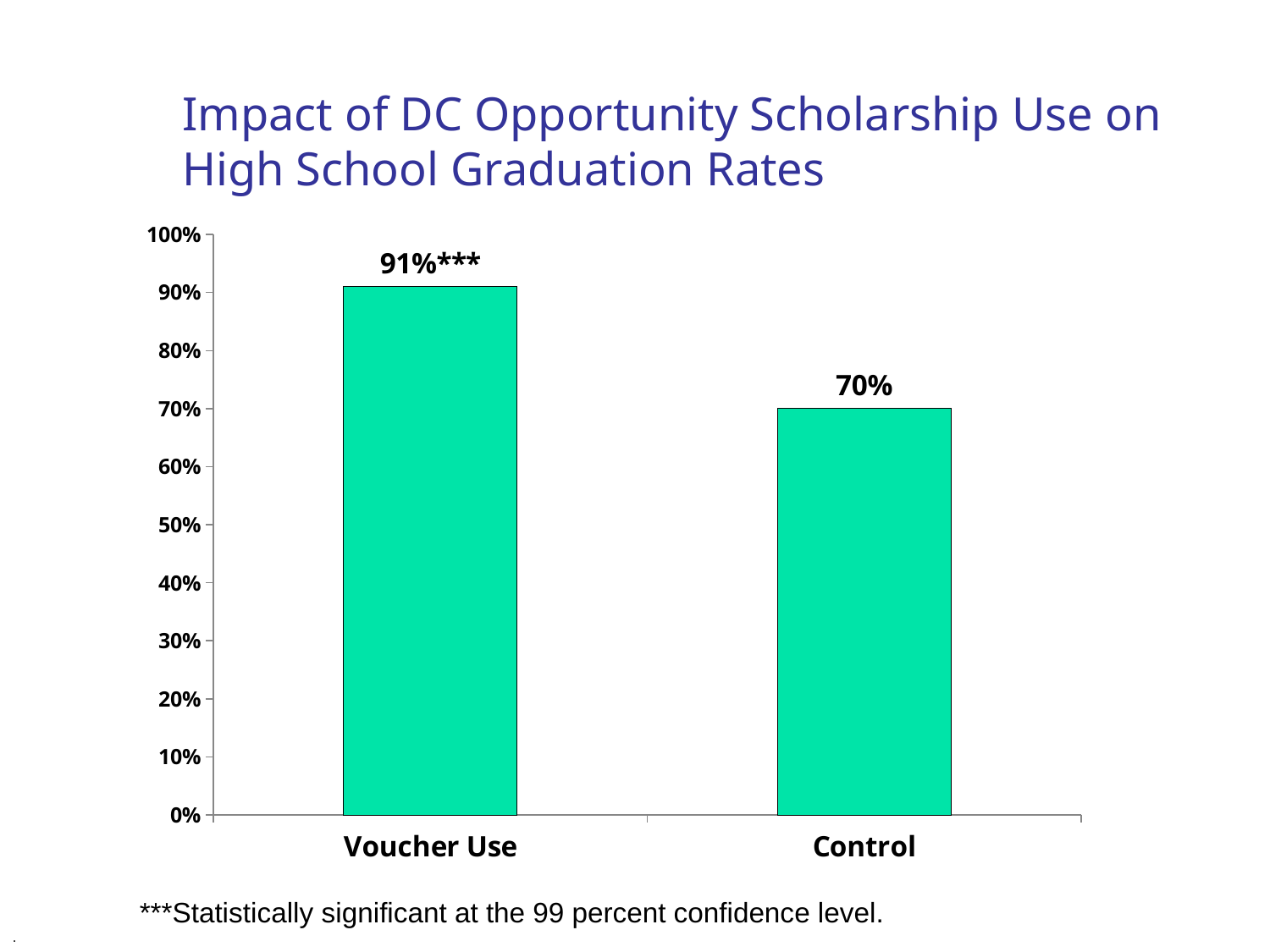
What kind of chart is shown on the slide? bar chart Which category has the lowest graduation rate? Control How many categories are shown on the x axis? 2 Which category has the highest graduation rate? Voucher Use What is the graduation rate for Control? 70% What does the *** marker next to the Voucher Use value indicate? Statistically significant at the 99 percent confidence level What is the difference in graduation rate between Voucher Use and Control? 21% What is the title of the slide? Impact of DC Opportunity Scholarship Use on High School Graduation Rates Is the value for Control greater or less than 80%? less Which is larger, the graduation rate for Voucher Use or for Control? Voucher Use Is the value for Voucher Use greater or less than 90%? greater What is the graduation rate for Voucher Use? 91%